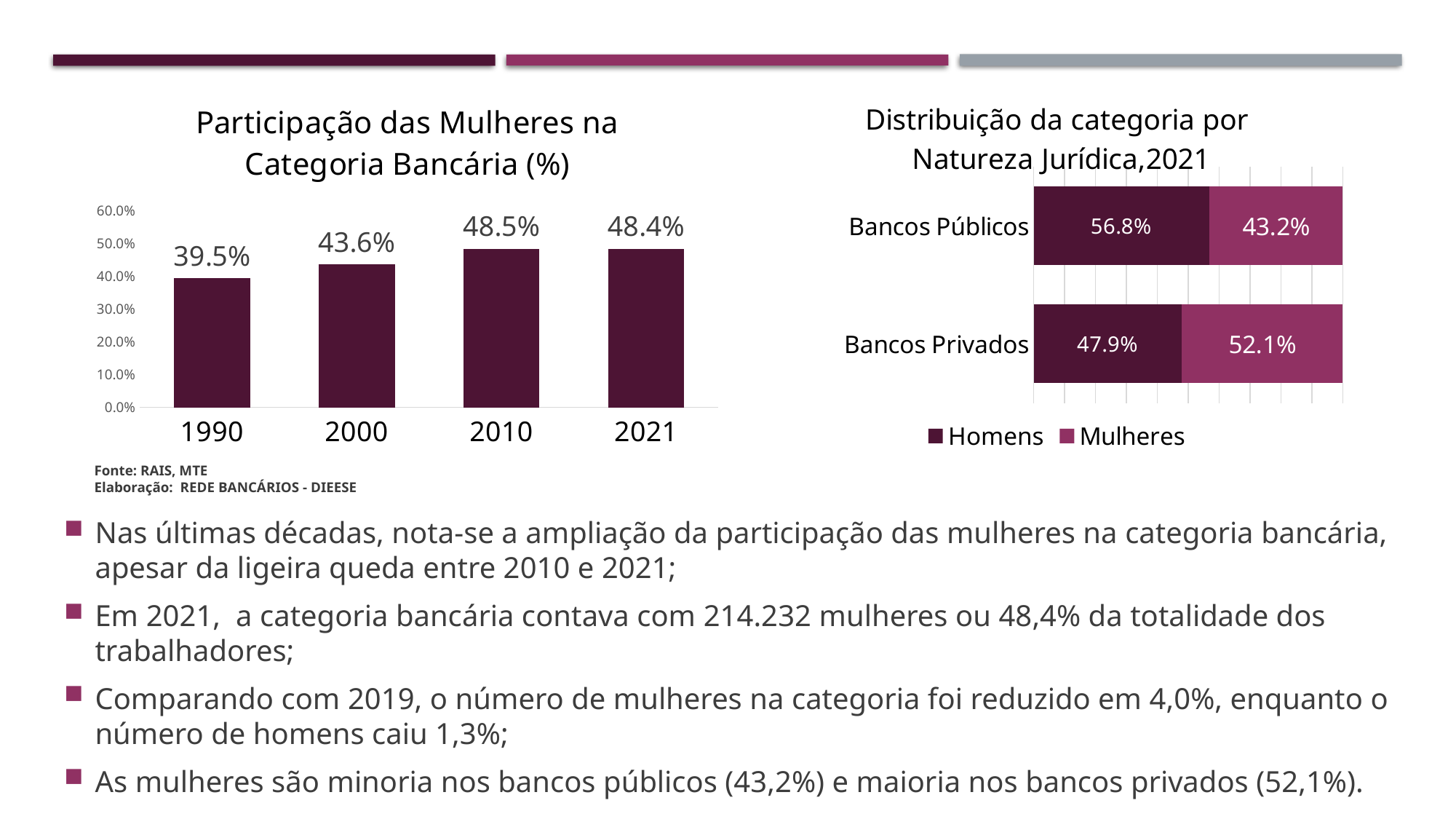
In the chart 'Participação das Mulheres na Categoria Bancária (%)', which year has the lowest value? 1990 In the chart 'Distribuição da categoria por Natureza Jurídica,2021', what is the Mulheres value for Bancos Públicos? 43.2% In the chart 'Distribuição da categoria por Natureza Jurídica,2021', what is the total of the Bancos Privados bar? 100% In the chart 'Participação das Mulheres na Categoria Bancária (%)', what is the value for 2021? 48.4% In the chart 'Participação das Mulheres na Categoria Bancária (%)', which year has the highest value? 2010 In the chart 'Distribuição da categoria por Natureza Jurídica,2021', what is the Homens value for Bancos Privados? 47.9% In the chart 'Participação das Mulheres na Categoria Bancária (%)', what is the difference between the values for 2000 and 1990? 4.1% In the chart 'Distribuição da categoria por Natureza Jurídica,2021', which is larger for Bancos Públicos: Homens or Mulheres? Homens In the chart 'Participação das Mulheres na Categoria Bancária (%)', how many years are shown on the x axis? 4 In the chart 'Participação das Mulheres na Categoria Bancária (%)', what is the value for 1990? 39.5% What kind of chart is 'Participação das Mulheres na Categoria Bancária (%)'? Bar chart How many series does the legend of the chart 'Distribuição da categoria por Natureza Jurídica,2021' list? 2